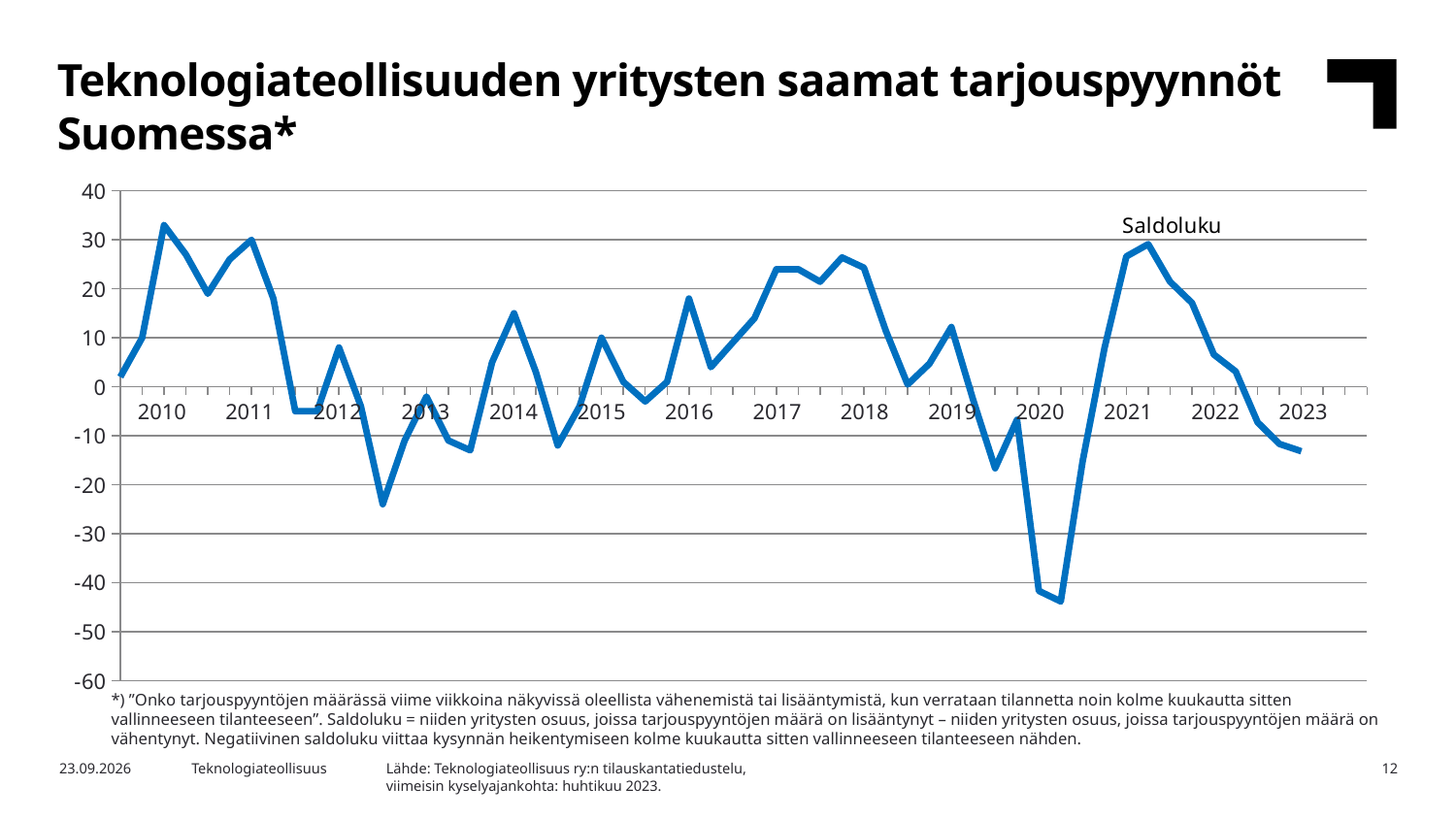
What is the title of the chart on the slide? Teknologiateollisuuden yritysten saamat tarjouspyynnöt Suomessa* What is the name of the series plotted in the chart? Saldoluku Is the Saldoluku value at the end of 2023 higher or lower than the value at the start of 2010? lower What kind of chart is shown on the slide? line chart Is the peak value of the Saldoluku line in 2010 greater or less than 30? greater How many years are labelled on the x axis of the chart? 14 In which year does the Saldoluku line reach its lowest value? 2020 Is the lowest value of the Saldoluku line in 2020 greater or less than -40? less Is the last value of the Saldoluku line in 2023 greater or less than -10? less Does the Saldoluku line rise or fall from its 2021 peak to the end of 2023? fall How many series are plotted in the chart? 1